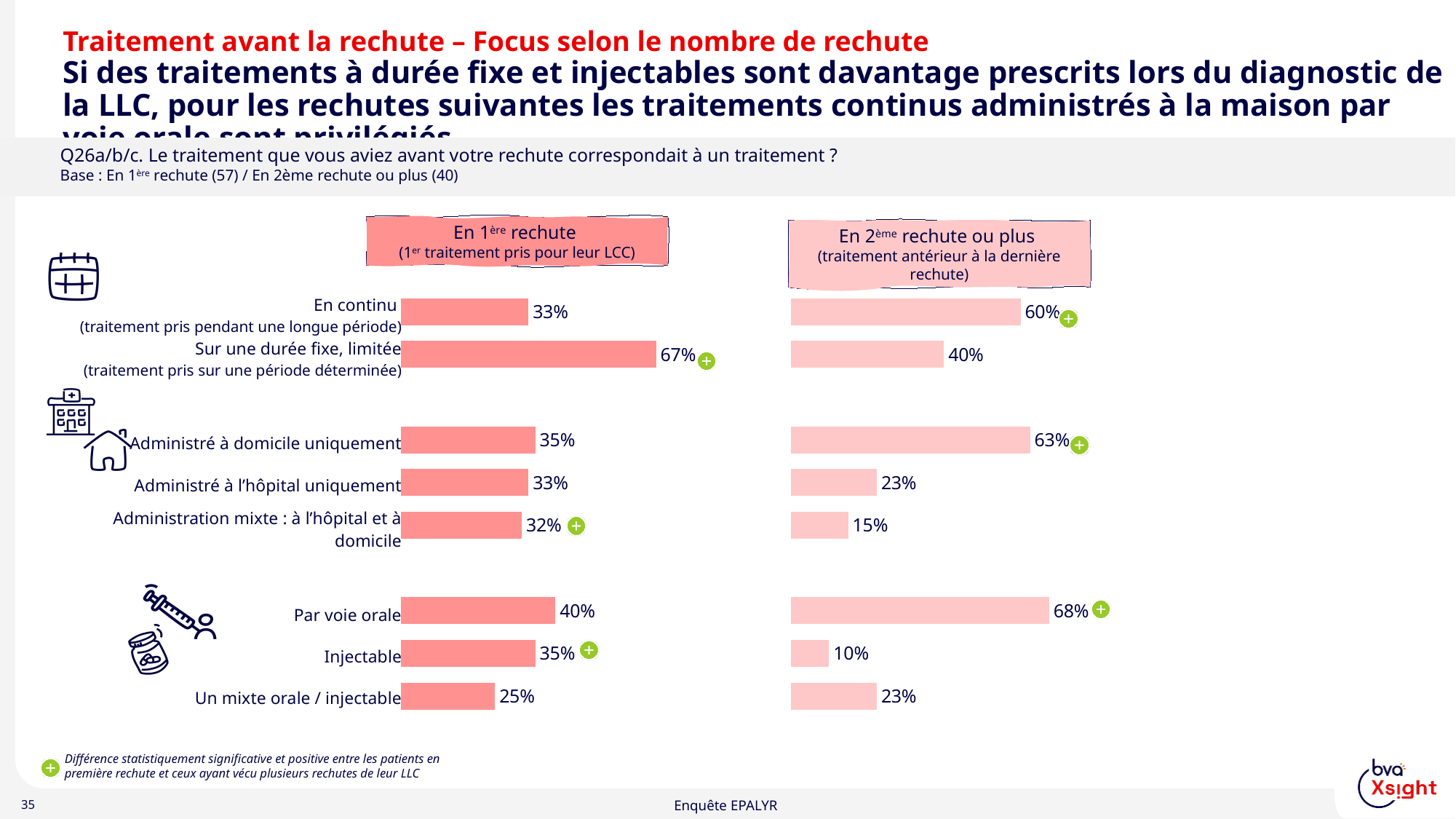
What kind of chart is used on this slide? Bar chart In the 'En 2ème rechute ou plus' chart, what is the value for 'Injectable'? 10% What is the difference between 'Sur une durée fixe, limitée' and 'En continu' in the 'En 1ère rechute' chart? 34 percentage points In the 'En 2ème rechute ou plus' chart, which category has the highest value? Par voie orale Which is larger: 'Administré à domicile uniquement' in the 'En 1ère rechute' chart or in the 'En 2ème rechute ou plus' chart? En 2ème rechute ou plus How many categories are plotted in the 'En 1ère rechute' chart? 9 In the 'En 1ère rechute' chart, which category has the lowest value? Un mixte orale / injectable In the 'En 1ère rechute' chart, what is the value for 'Administration mixte : à l'hôpital et à domicile'? 32% In the 'En 2ème rechute ou plus' chart, what is the value for 'En continu'? 60% What is the difference between the 'Par voie orale' values in the 'En 2ème rechute ou plus' chart and the 'En 1ère rechute' chart? 28 percentage points In the 'En 2ème rechute ou plus' chart, which category has the lowest value? Injectable In the 'En 1ère rechute' chart, what is the value for 'Sur une durée fixe, limitée'? 67%